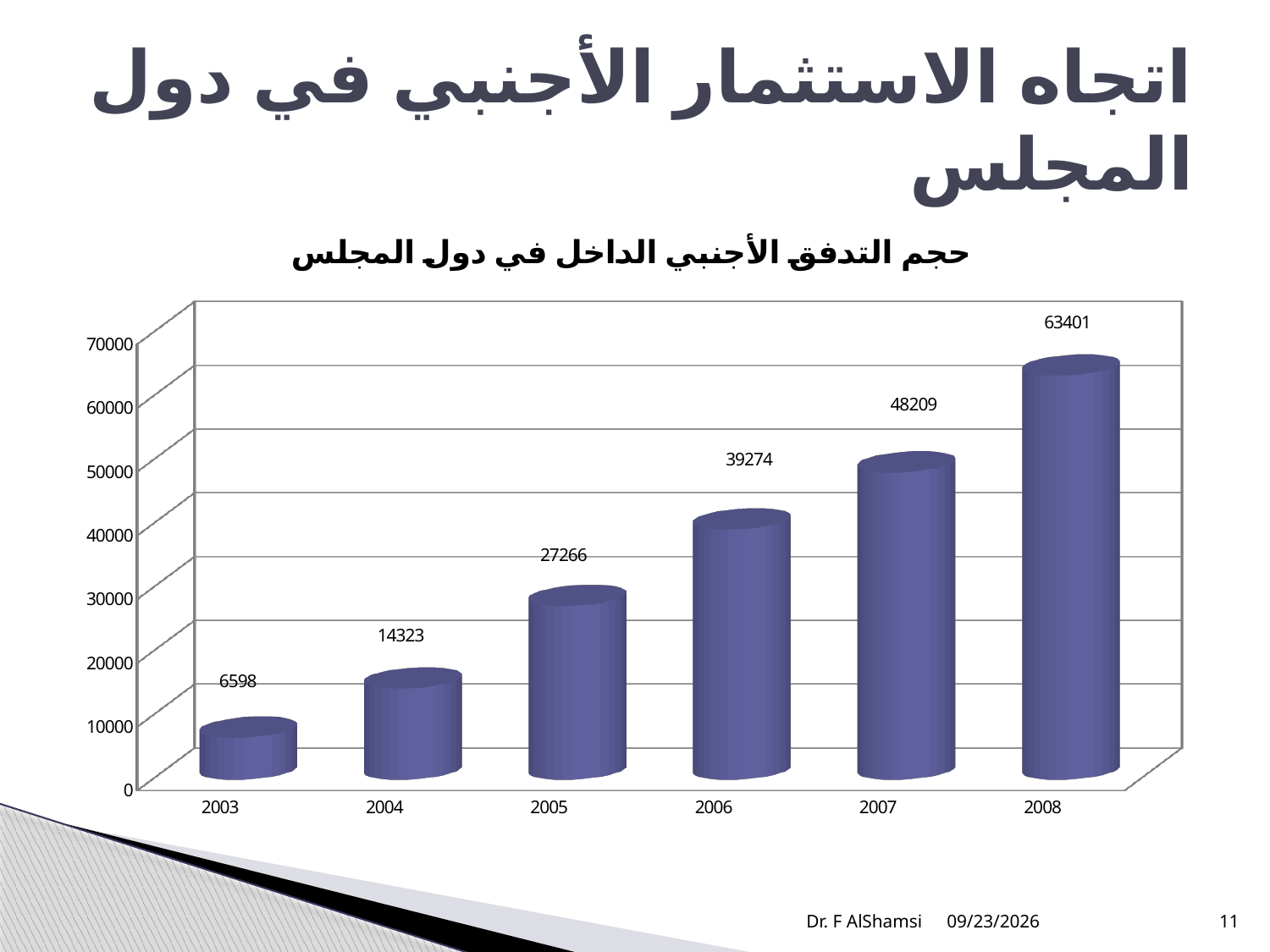
Which year has the highest value? 2008 What is the value for 2007? 48209 What kind of chart is shown on the slide? bar chart Which year has the lowest value? 2003 How many years are shown on the x axis? 6 Is the value for 2006 greater or less than 30000? greater Do the values rise or fall from 2003 to 2008? rise Which is larger, the value for 2006 or the value for 2005? 2006 What is the value for 2003? 6598 What is the value for 2005? 27266 What is the difference between the values for 2008 and 2007? 15192 What is the difference between the values for 2004 and 2003? 7725